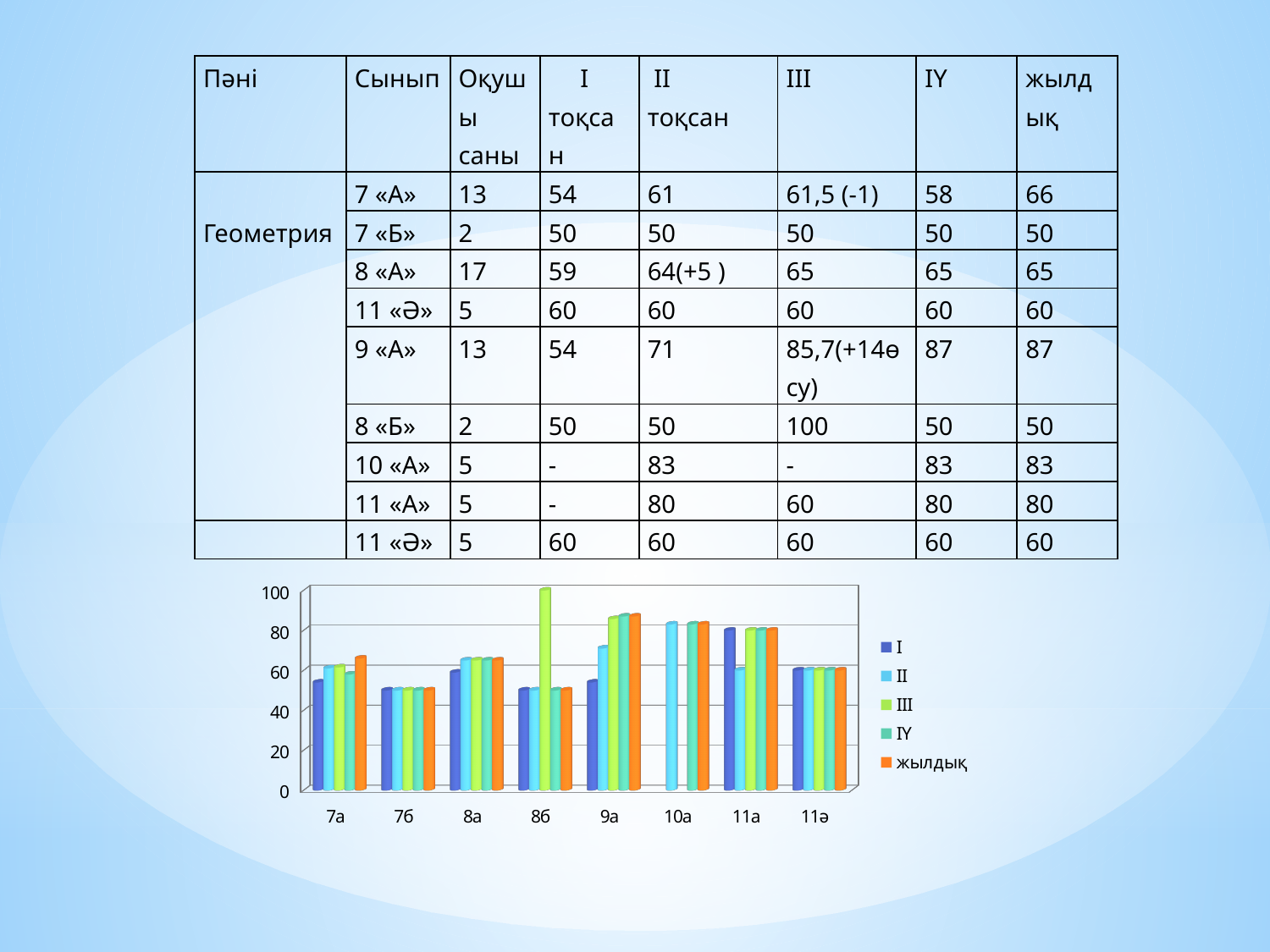
Is the value of series I for 11а greater or less than 60? greater Is the value of жылдық for 7б greater or less than 60? less How many series does the chart legend list? 5 What is the value of series III for 8б in the chart? 100 What is the value of series I for 11ә in the chart? 60 Which is larger in the chart: the жылдық value for 9а or the жылдық value for 7а? 9а Which series have no bar for 10а in the chart? I and III What are the entries listed in the chart legend? I, II, III, IY, жылдық Which category has the tallest bar for series III in the chart? 8б What kind of chart is shown on the slide? bar chart Is the value of series II for 10а greater or less than 80? greater How many class categories are shown on the x axis of the chart? 8